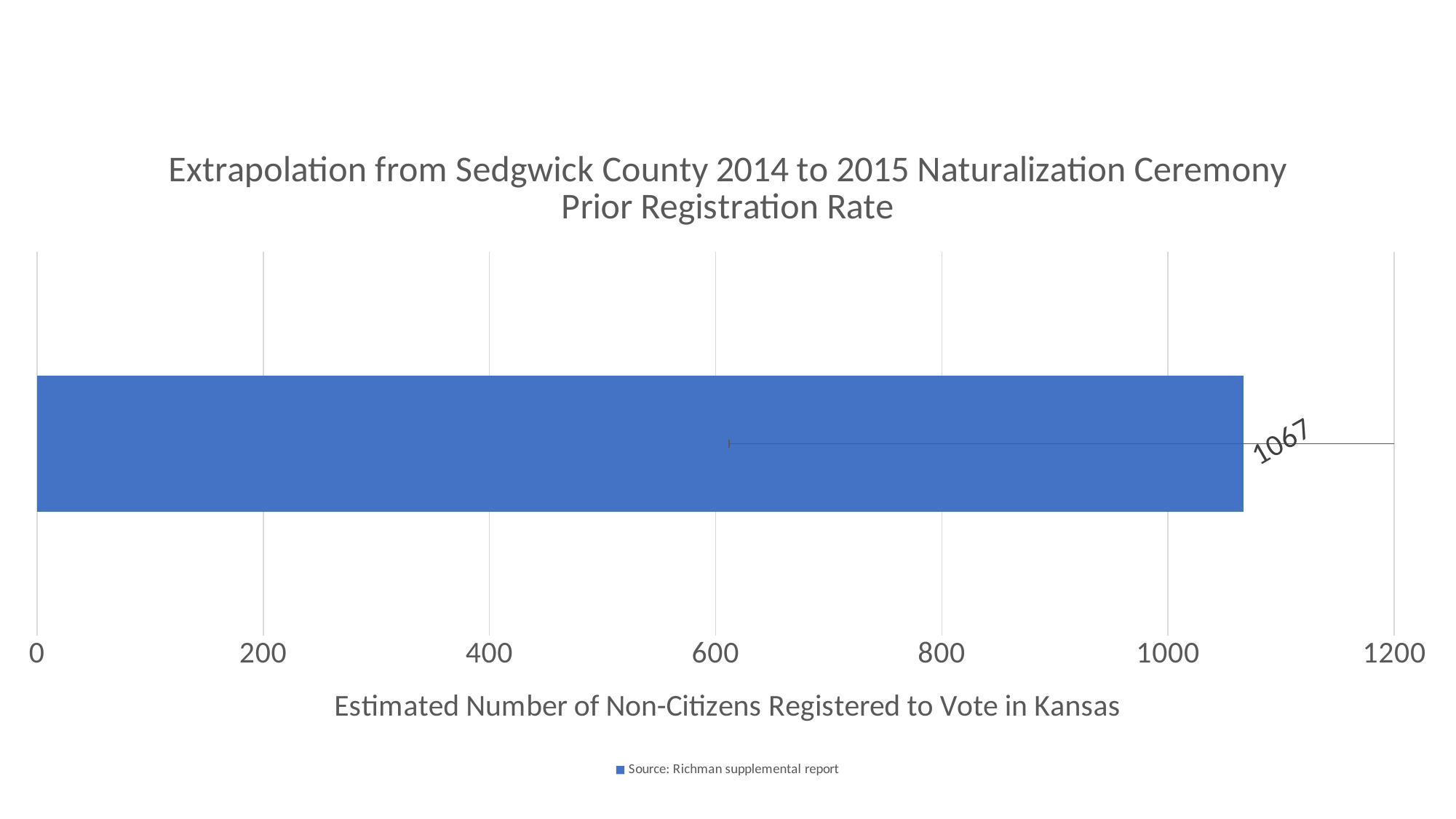
What is the x-axis title of the chart? Estimated Number of Non-Citizens Registered to Vote in Kansas Is the value of the bar greater or less than 1200? less What kind of chart is shown on the slide? bar chart What is the title of the chart? Extrapolation from Sedgwick County 2014 to 2015 Naturalization Ceremony Prior Registration Rate What is the maximum value shown on the x axis? 1200 How many bars are plotted in the chart? 1 What is the value shown by the data label on the bar? 1067 How many series does the legend list? 1 Is the value of the bar greater or less than 1000? greater What is the difference between the bar's value and the 1200 axis maximum? 133